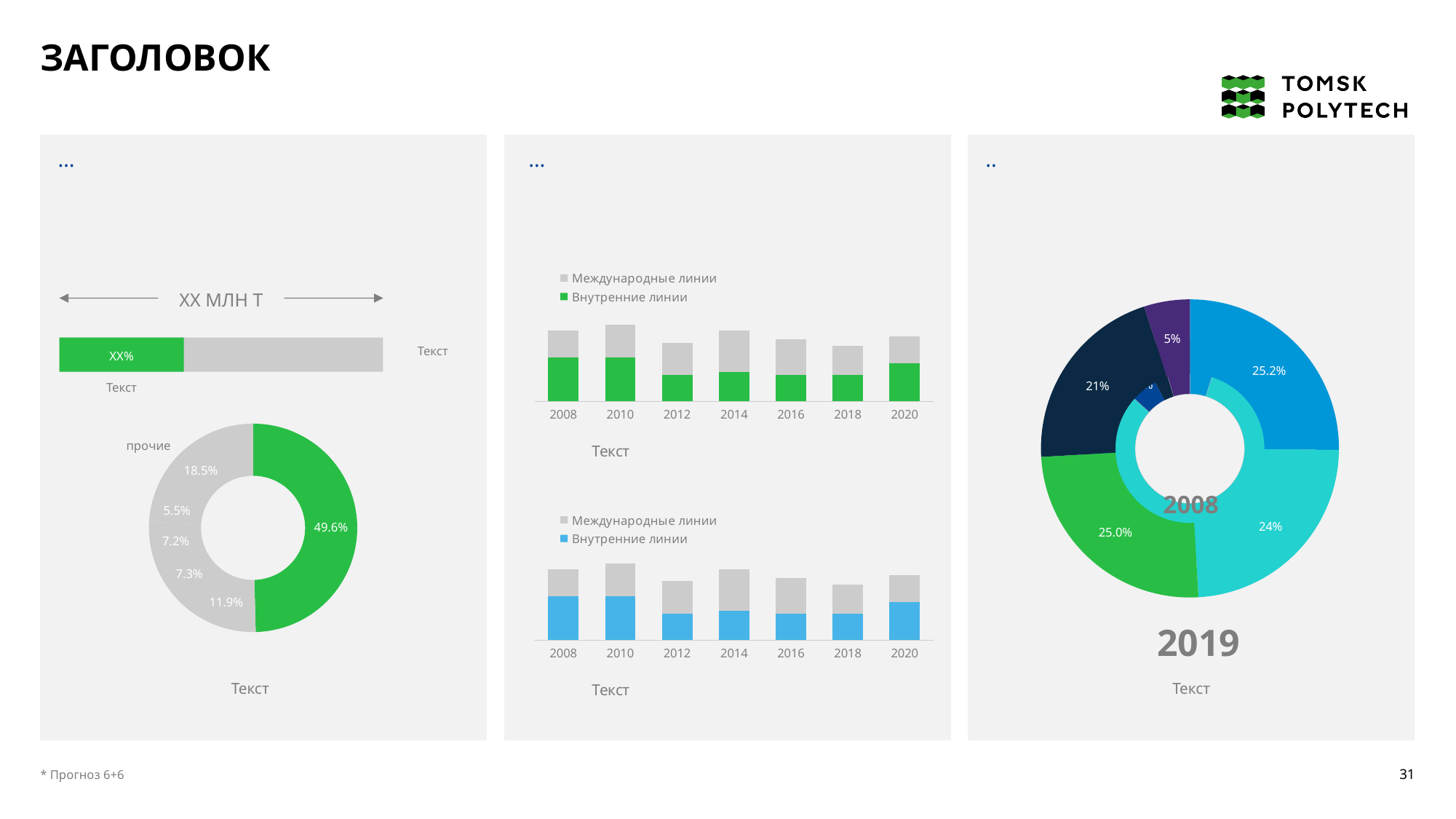
In the bottom bar chart of the middle panel, which year has the tallest total bar? 2010 In the donut chart on the left panel, what is the largest slice value? 49.6% In the top bar chart of the middle panel, is the total bar for 2010 or 2012 taller? 2010 What kind of chart is the bottom chart in the middle panel? Stacked bar chart In the donut chart on the left panel, what value is shown for the slice labelled "прочие"? 18.5% In the donut chart on the left panel, what is the difference between the green slice (49.6%) and the "прочие" slice (18.5%)? 31.1% In the donut chart on the left panel, how many slices are there? 6 In the donut chart on the right panel, what is the largest labelled value? 25.2% In the donut chart on the left panel, what is the smallest slice value? 5.5% In the top bar chart of the middle panel, how many years are shown on the x axis? 7 In the donut chart on the left panel, what value is shown for the green slice? 49.6% In the top bar chart of the middle panel, how many series does the legend list? 2